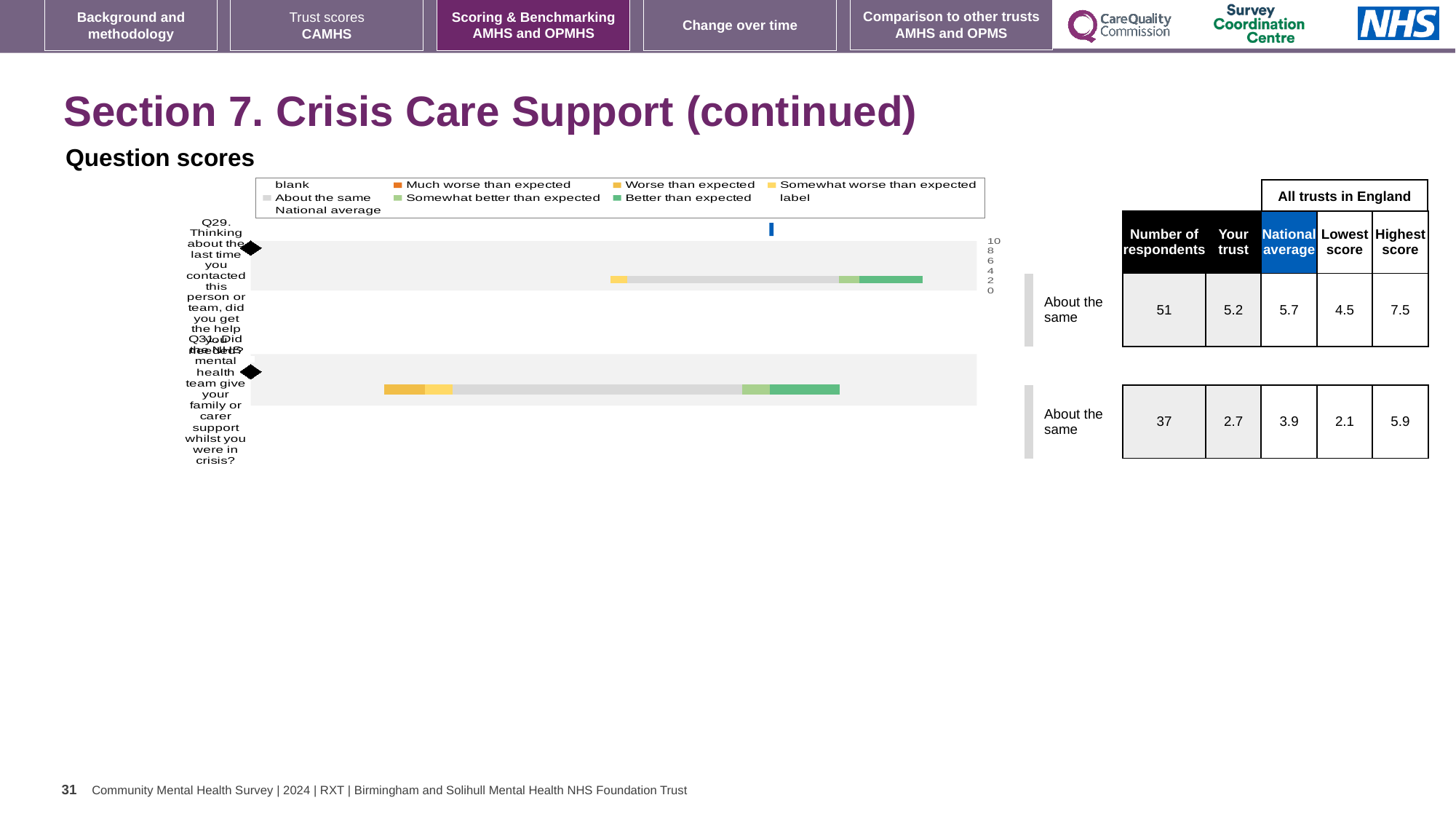
What colour does the legend use for 'Better than expected'? green What is the highest score across all trusts in England shown for Q31? 5.9 What is the difference between the national average and the 'Your trust' score for Q31? 1.2 What is the number of respondents shown for Q29? 51 What is the national average shown for Q31? 3.9 Which of the two questions has the higher 'Your trust' score? Q29 How many questions (categories) are plotted in the question scores chart? 2 What is the lowest score across all trusts in England shown for Q29? 4.5 For Q29, which is larger: the 'Your trust' score or the national average? National average Which two question numbers are shown as categories in the chart? Q29 and Q31 What is the 'Your trust' score shown for Q29? 5.2 What kind of chart is used to show the question scores on this slide? bar chart